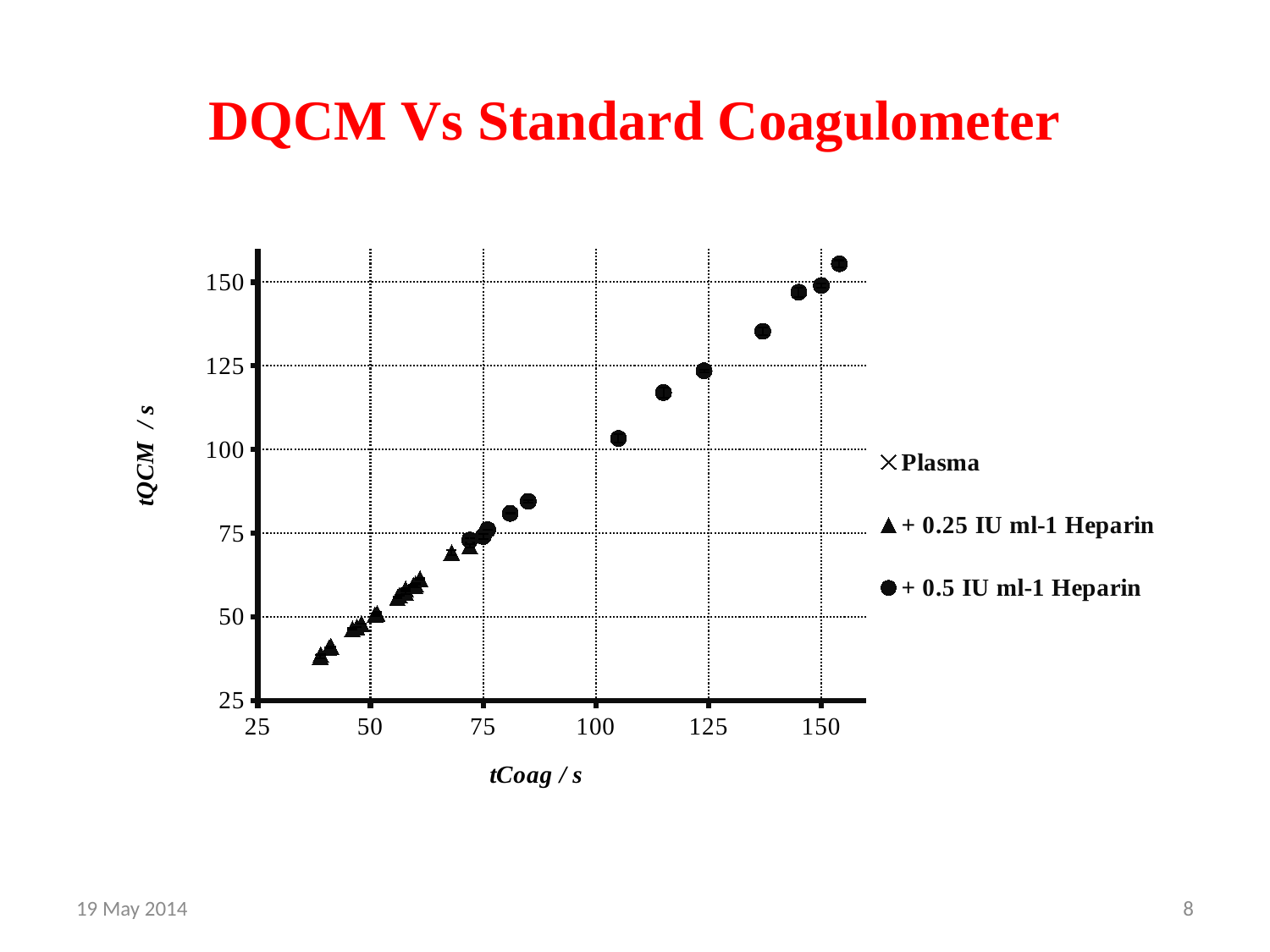
How many series does the legend list? 3 Which series reaches the highest tQCM values? + 0.5 IU ml-1 Heparin What is the title of the chart? DQCM Vs Standard Coagulometer Do the tQCM values rise or fall as tCoag increases along the x axis? rise What is the label of the x axis? tCoag / s Is the highest tQCM value for the + 0.5 IU ml-1 Heparin series greater or less than 150? greater Which series has the lowest tQCM values? + 0.25 IU ml-1 Heparin Is the lowest tQCM value for the + 0.25 IU ml-1 Heparin series greater or less than 50? less Which series has larger tCoag values overall, + 0.25 IU ml-1 Heparin or + 0.5 IU ml-1 Heparin? + 0.5 IU ml-1 Heparin What kind of chart is shown on the slide? scatter chart Is the highest tCoag value for the + 0.25 IU ml-1 Heparin series greater or less than 100? less